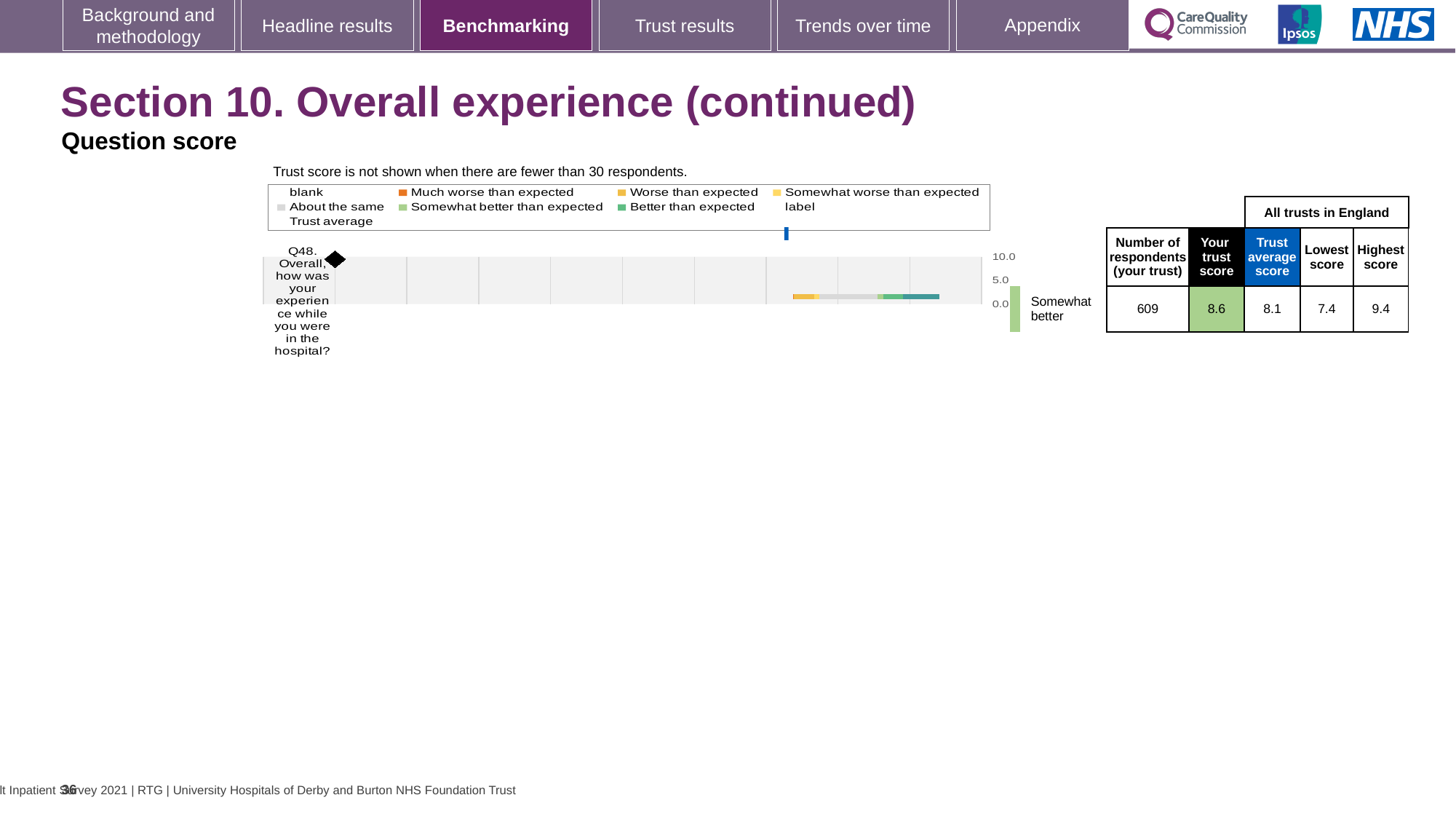
Which is larger for Q48: your trust score or the trust average score? Your trust score How many survey questions are plotted on the chart? 1 What is your trust score for Q48? 8.6 What is the difference between the highest score and the lowest score for Q48? 2.0 What is the lowest score among all trusts in England for Q48? 7.4 What is the highest score among all trusts in England for Q48? 9.4 What is the highest tick value shown on the chart's score axis? 10.0 What kind of chart is used to show the Q48 benchmarking result? bar chart What is the trust average score for all trusts in England for Q48? 8.1 By how much does your trust score exceed the trust average score for Q48? 0.5 What benchmark category label is shown next to the Q48 bar? Somewhat better What is the number of respondents (your trust) shown for Q48? 609